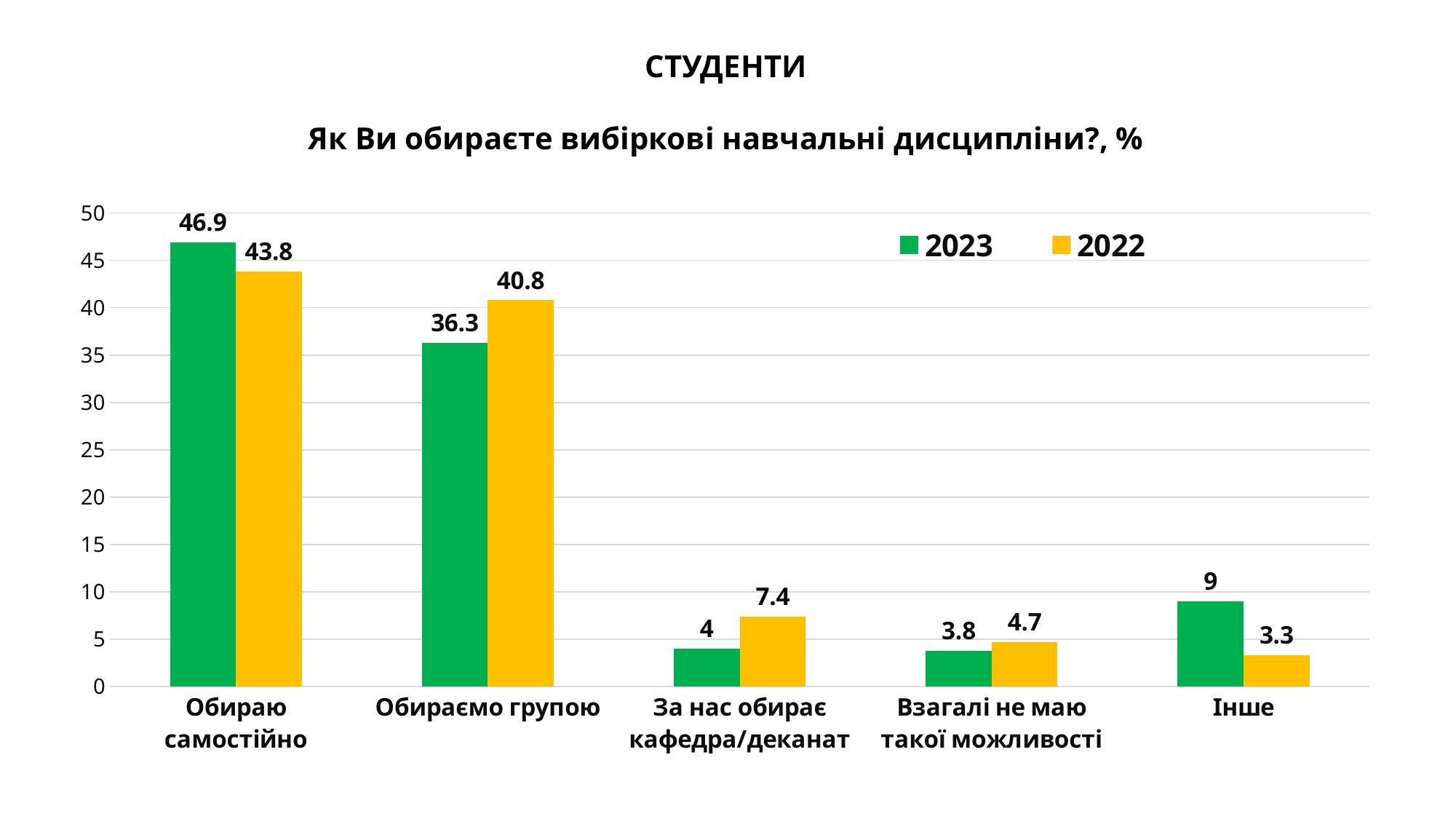
Which category has the lowest 2022 value? Інше What is the 2023 value for "Інше"? 9 Which category has the highest 2023 value? Обираю самостійно How many series does the legend list? 2 How many categories are shown on the x axis? 5 What is the 2022 value for "Обираємо групою"? 40.8 Which is larger for "Обираємо групою": the 2023 value or the 2022 value? 2022 What kind of chart is shown on the slide? Bar chart What is the difference between the 2023 and 2022 values for "Обираю самостійно"? 3.1 What is the 2022 value for "За нас обирає кафедра/деканат"? 7.4 What is the 2023 value for "Обираю самостійно"? 46.9 Which colour represents the 2022 series? Yellow